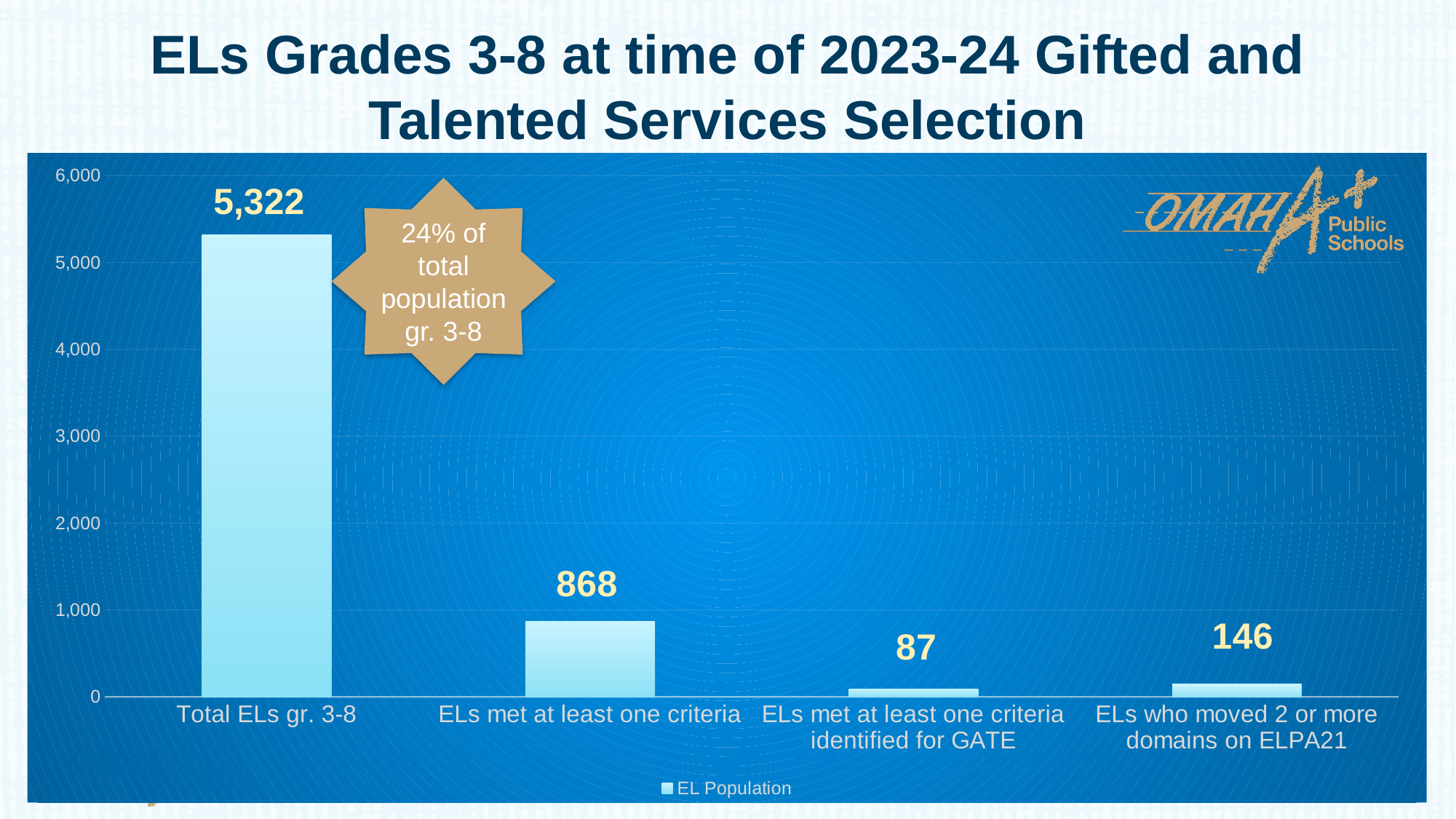
What kind of chart is shown on the slide? Bar chart How many categories are shown on the x axis? 4 What is the value for ELs met at least one criteria identified for GATE? 87 What is the value for ELs who moved 2 or more domains on ELPA21? 146 What is the value for ELs met at least one criteria? 868 Which category has the highest value? Total ELs gr. 3-8 Which is larger: the value for ELs met at least one criteria or the value for ELs who moved 2 or more domains on ELPA21? ELs met at least one criteria Which category has the lowest value? ELs met at least one criteria identified for GATE What is the difference between the values for ELs who moved 2 or more domains on ELPA21 and ELs met at least one criteria identified for GATE? 59 What is the value for Total ELs gr. 3-8? 5,322 What is the difference between the values for Total ELs gr. 3-8 and ELs met at least one criteria? 4,454 What series name does the legend list? EL Population